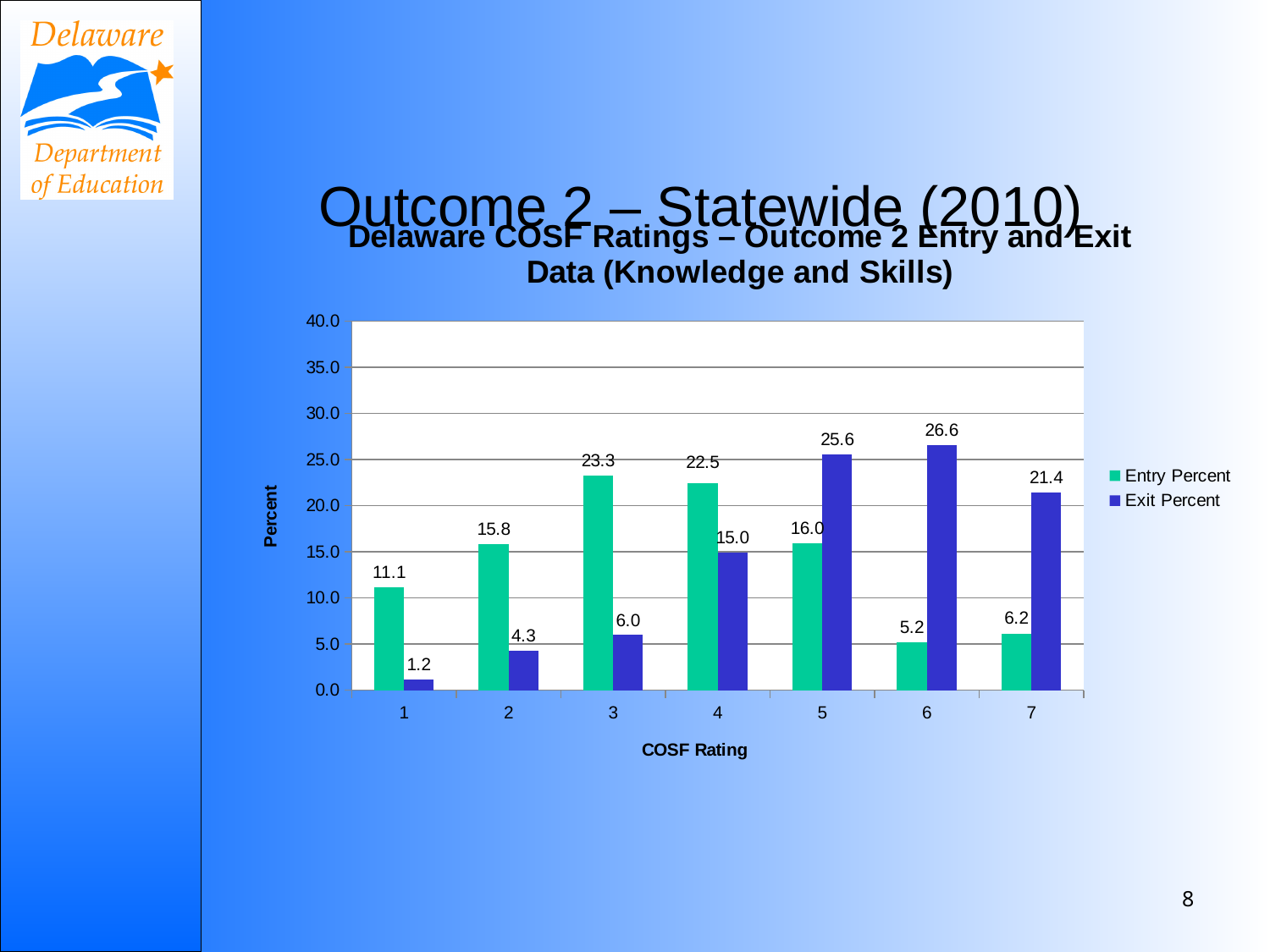
What is the difference between the Exit Percent and the Entry Percent for COSF Rating 7? 15.2 What is the label of the y axis? Percent Which COSF Rating has the highest Exit Percent? 6 How many COSF Rating categories are shown on the x axis? 7 Which is larger for COSF Rating 4, the Entry Percent or the Exit Percent? Entry Percent Is the Exit Percent for COSF Rating 5 greater or less than 20.0? greater What is the Entry Percent for COSF Rating 3? 23.3 How many series does the legend list? 2 What is the Exit Percent for COSF Rating 1? 1.2 What kind of chart is shown on the slide? Bar chart What is the Exit Percent for COSF Rating 6? 26.6 Which COSF Rating has the lowest Entry Percent? 6